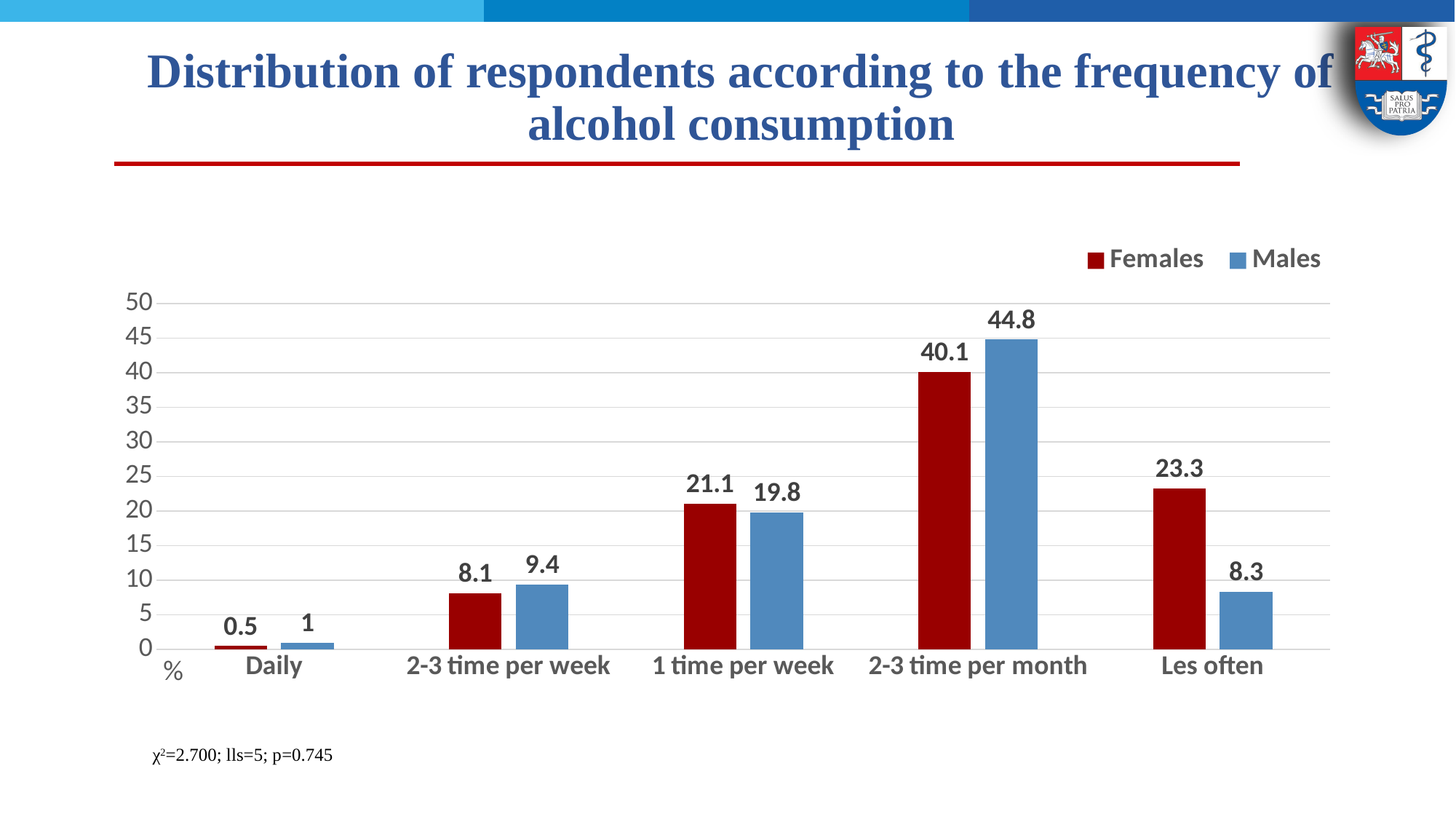
What is the value for Males in the 'Les often' category? 8.3 How many series does the legend list? 2 What is the value for Males in the 'Daily' category? 1 What kind of chart is shown on the slide? Bar chart What is the value for Females in the '2-3 time per month' category? 40.1 How many categories are shown on the x axis? 5 Which category has the lowest value for Females? Daily What is the difference between the Females and Males values in the 'Les often' category? 15 In the '1 time per week' category, which is larger: Females or Males? Females What colour represents the Females series? Dark red What is the difference between the Males and Females values in the '2-3 time per month' category? 4.7 Which category has the highest value for Males? 2-3 time per month